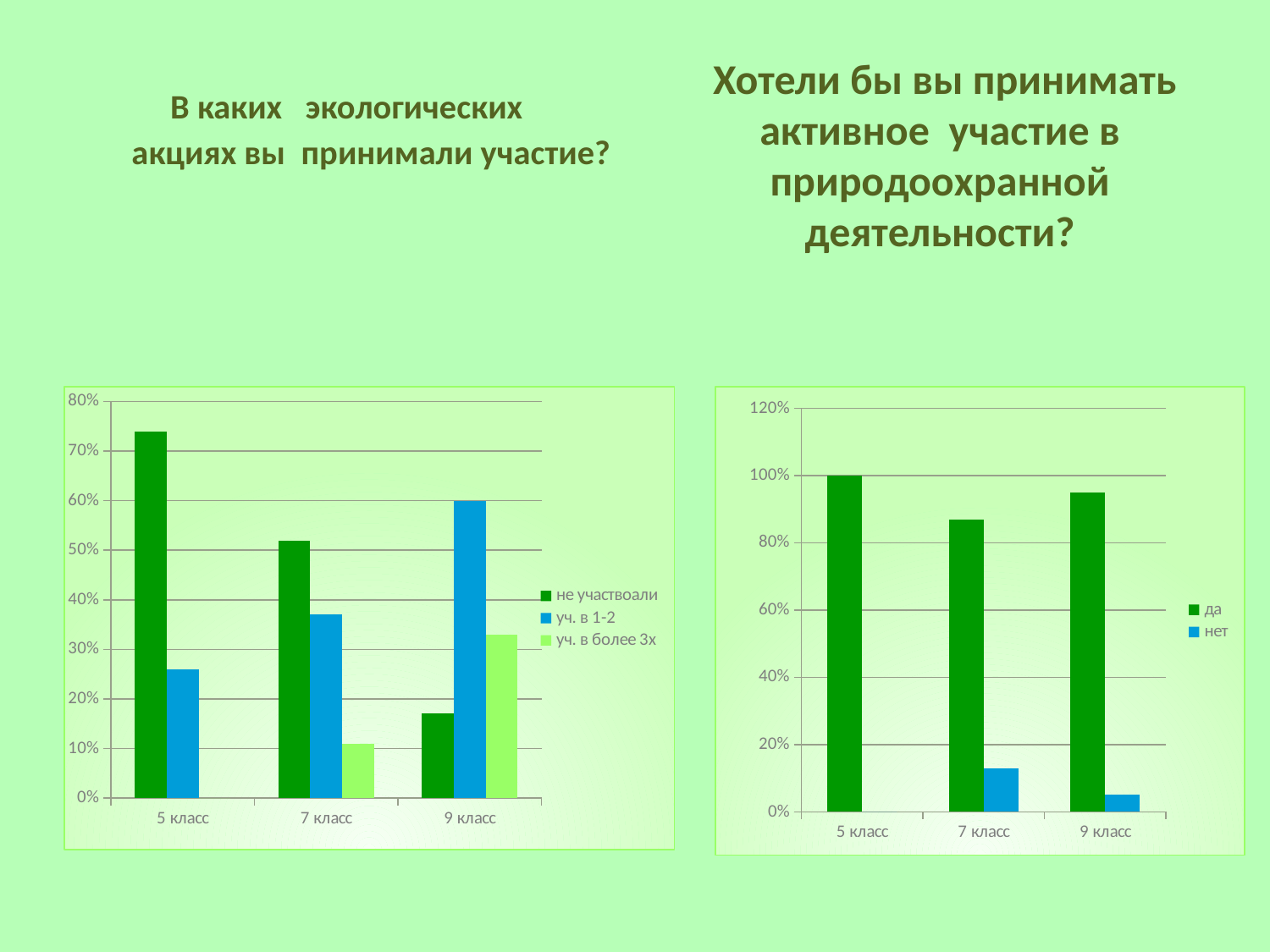
On the left chart, which class has the highest value for 'уч. в 1-2'? 9 класс On the right chart, what is the value of 'да' for 5 класс? 100% On the left chart, is the value of 'не участвоали' for 5 класс greater or less than 70%? greater On the right chart, which is larger for 7 класс: 'да' or 'нет'? да On the left chart (В каких экологических акциях вы принимали участие?), how many series does the legend list? 3 On the left chart, does the value of 'не участвоали' rise or fall from 5 класс to 9 класс? fall On the right chart (Хотели бы вы принимать активное участие в природоохранной деятельности?), how many series does the legend list? 2 On the left chart, is the value of 'уч. в более 3х' for 7 класс greater or less than 20%? less What kind of chart is the right chart? bar chart On the left chart, which class has the highest value for 'не участвоали'? 5 класс On the left chart, which class has the lowest value for 'не участвоали'? 9 класс On the left chart, how many class categories are shown on the x axis? 3